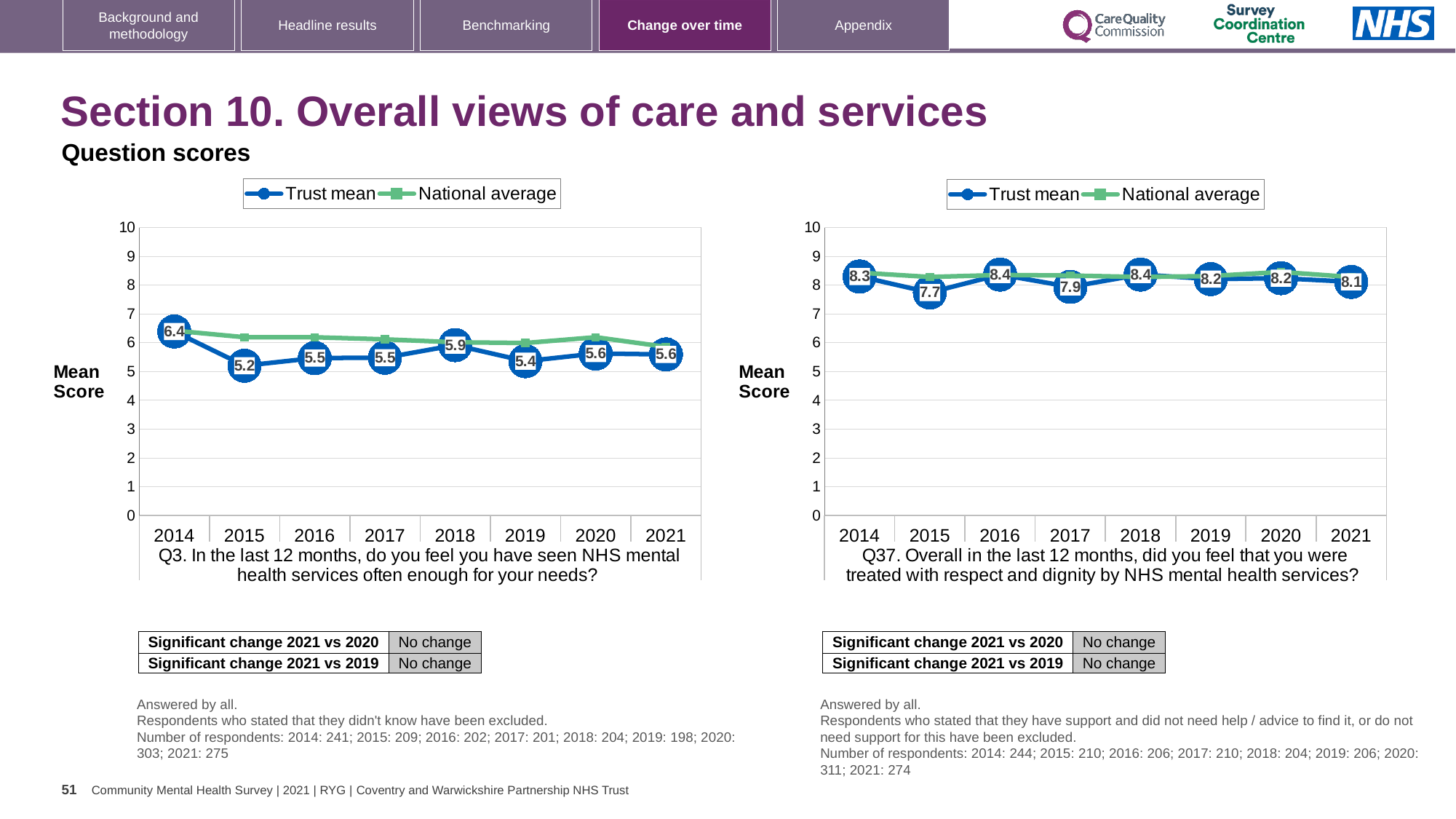
In the left chart (Q3), which year has the highest Trust mean score? 2014 In the right chart (Q37), which year has the lowest Trust mean score? 2015 In the right chart (Q37), what is the Trust mean score for 2017? 7.9 In the right chart (Q37), what is the difference between the Trust mean scores for 2016 and 2021? 0.3 In the right chart (Q37), is the Trust mean score for 2018 higher or lower than for 2019? higher How many years are plotted on the x axis of the right chart (Q37)? 8 In the left chart (Q3), what is the Trust mean score for 2021? 5.6 In the left chart (Q3), is the National average for 2014 greater or less than 5? greater What type of chart is the left chart (Q3)? line chart In the left chart (Q3), which year has the lowest Trust mean score? 2015 In the left chart (Q3), what is the difference between the Trust mean scores for 2014 and 2015? 1.2 In the left chart (Q3), what is the Trust mean score for 2014? 6.4